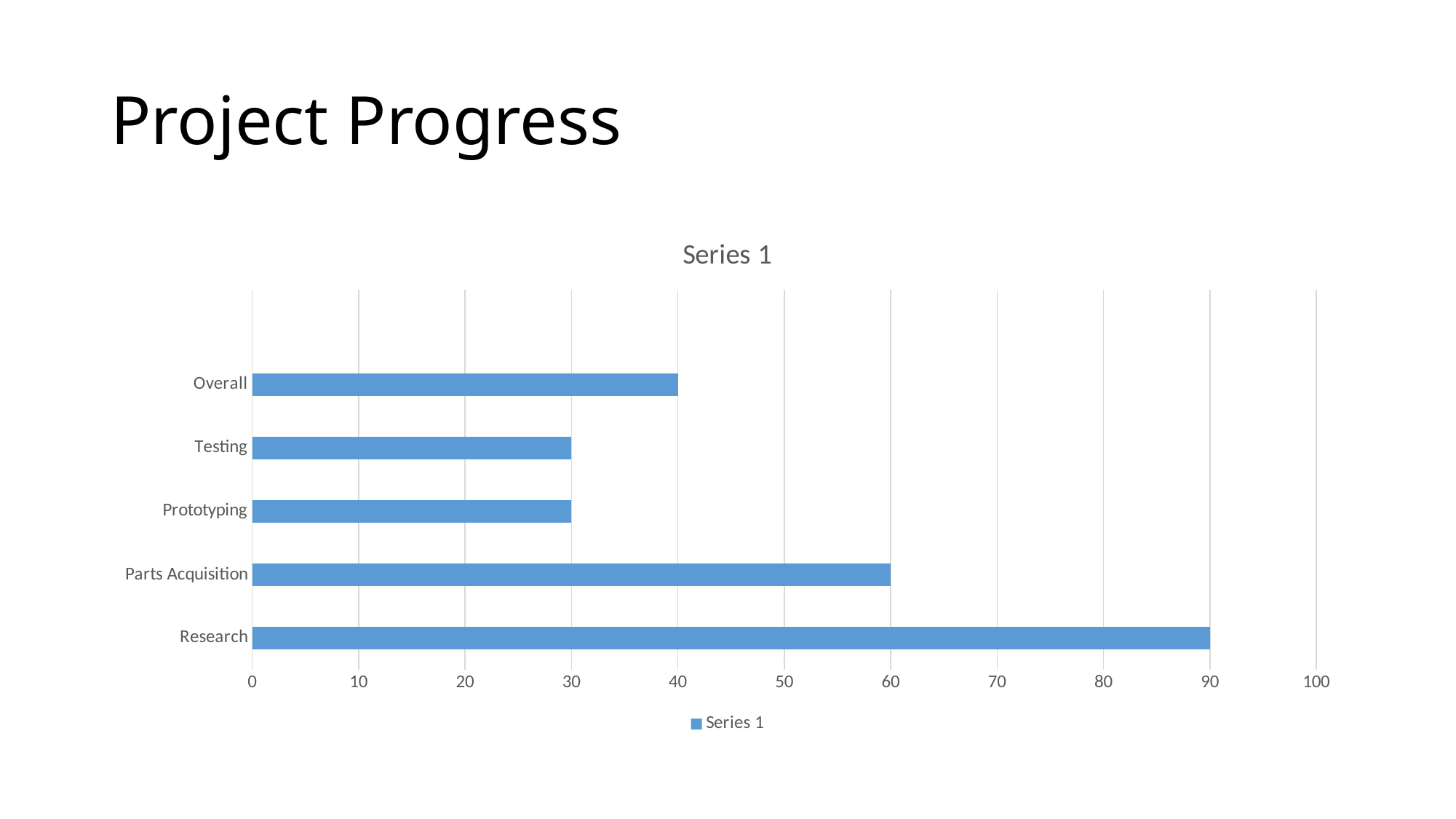
What is the title of the chart? Series 1 What is the value for Overall? 40 What is the value for Testing? 30 Is the value for Research greater or less than 80? greater How many series does the legend list? 1 What is the value for Research? 90 How many categories are shown on the chart? 5 What kind of chart is shown on the slide? bar chart Which is larger, the value for Overall or the value for Parts Acquisition? Parts Acquisition Which category has the highest value? Research What is the difference between the values for Research and Parts Acquisition? 30 What is the value for Parts Acquisition? 60